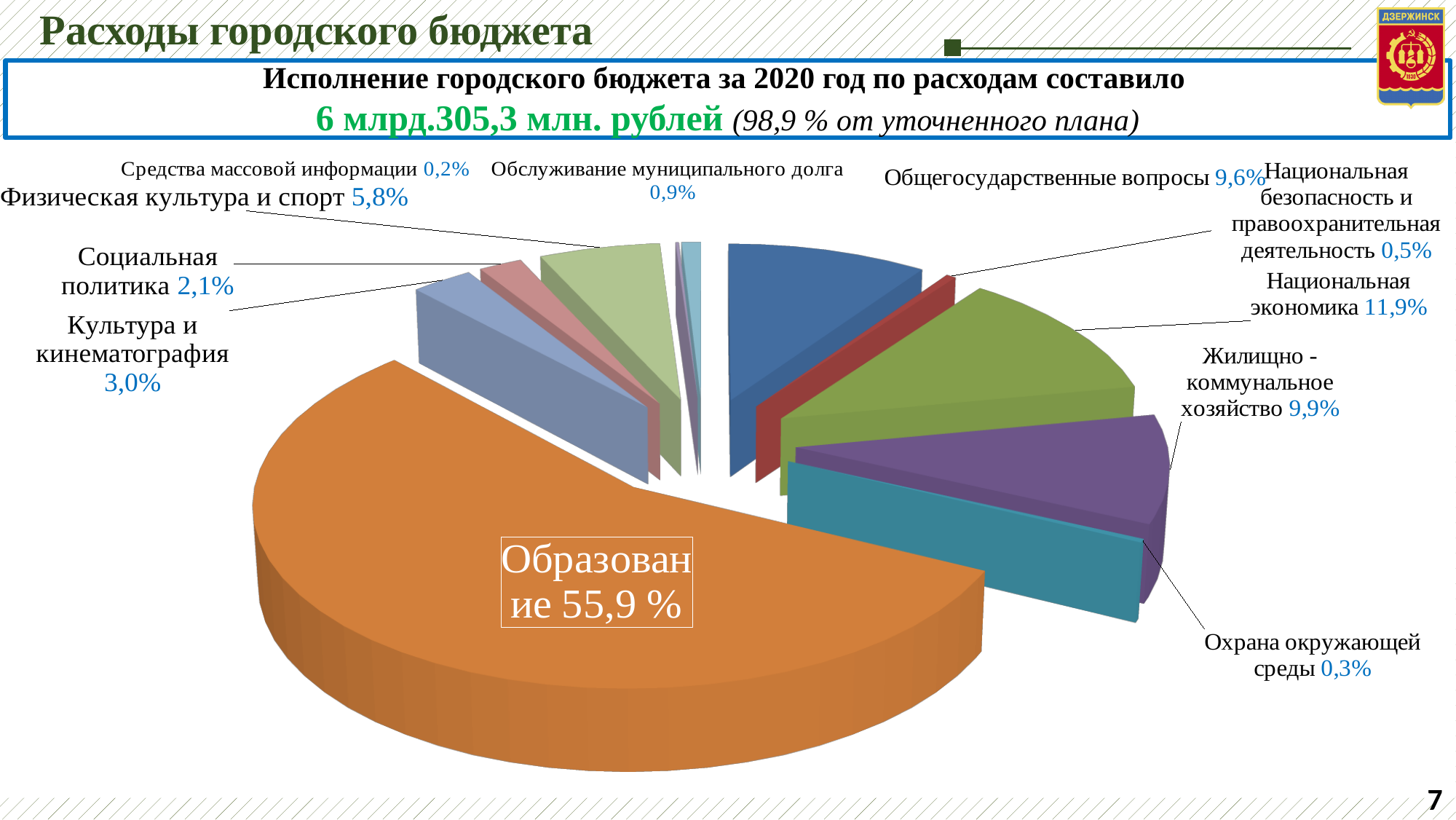
What is the difference between the shares of Национальная экономика and Общегосударственные вопросы? 2,3% What type of chart is shown on the slide? Pie chart Which is larger: the share for Физическая культура и спорт or for Культура и кинематография? Физическая культура и спорт What is the combined share of Социальная политика and Охрана окружающей среды? 2,4% What share of the pie chart does Образование account for? 55,9 % What colour is the Образование slice of the pie? Orange What is the value shown for Национальная экономика? 11,9% Which category has the smallest share of the pie? Средства массовой информации Which category has the largest share of the pie? Образование What percentage is shown for Жилищно-коммунальное хозяйство? 9,9% What is the value for Обслуживание муниципального долга? 0,9% How many categories are shown in the pie chart? 11